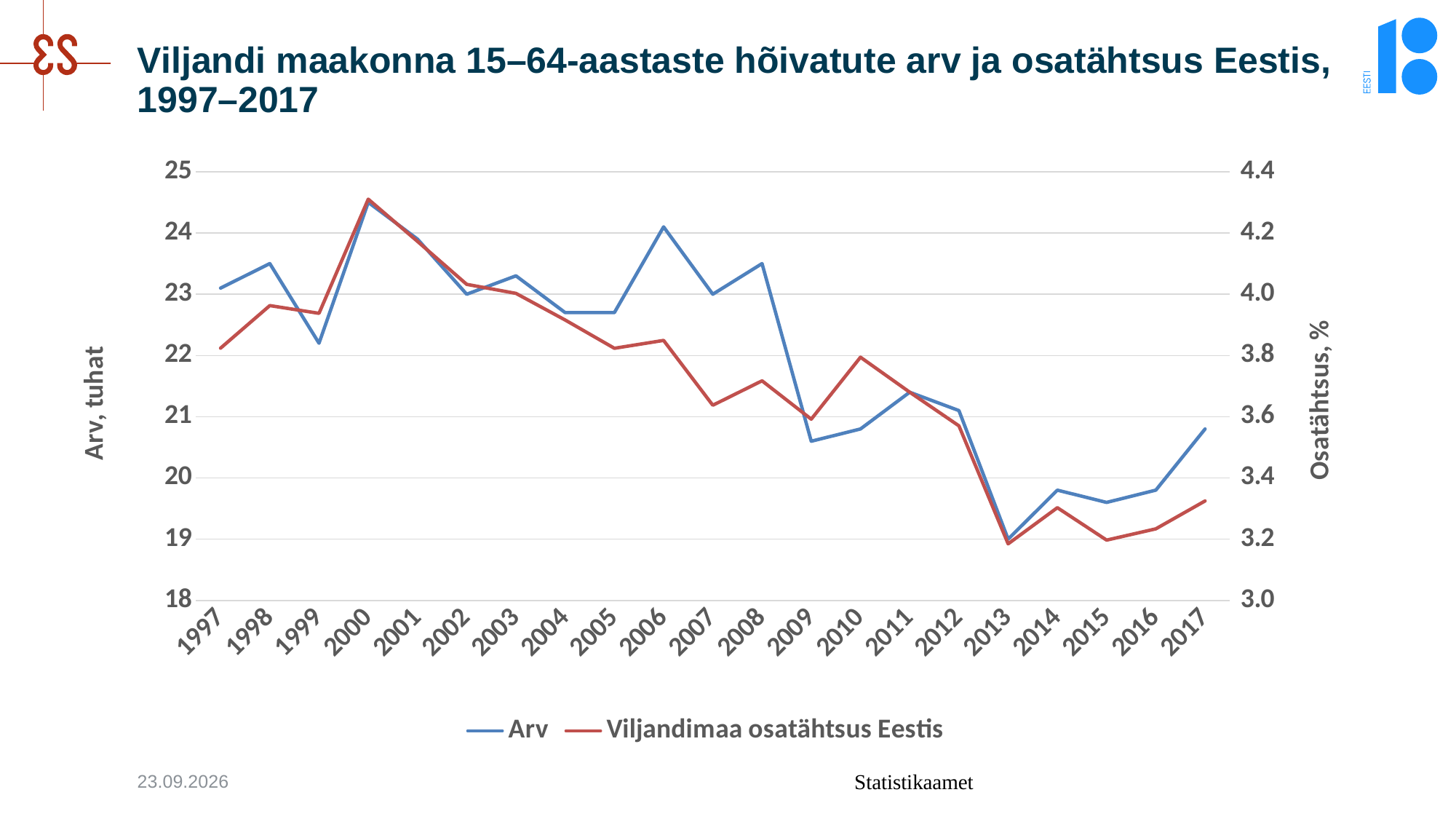
How many years are plotted along the x axis? 21 Is the value of Arv in 1999 greater or less than 22? greater What is the title of the left vertical axis? Arv, tuhat How many series does the legend list? 2 In which year does the Viljandimaa osatähtsus Eestis series reach its highest value? 2000 What kind of chart is shown on the slide? line chart In which year does the Arv series reach its highest value? 2000 Is the value of Arv in 2009 greater or less than 21? less Is the value of Viljandimaa osatähtsus Eestis in 2016 greater or less than 3.4? less In which year does the Arv series reach its lowest value? 2013 Which year has the larger Arv value, 2008 or 2009? 2008